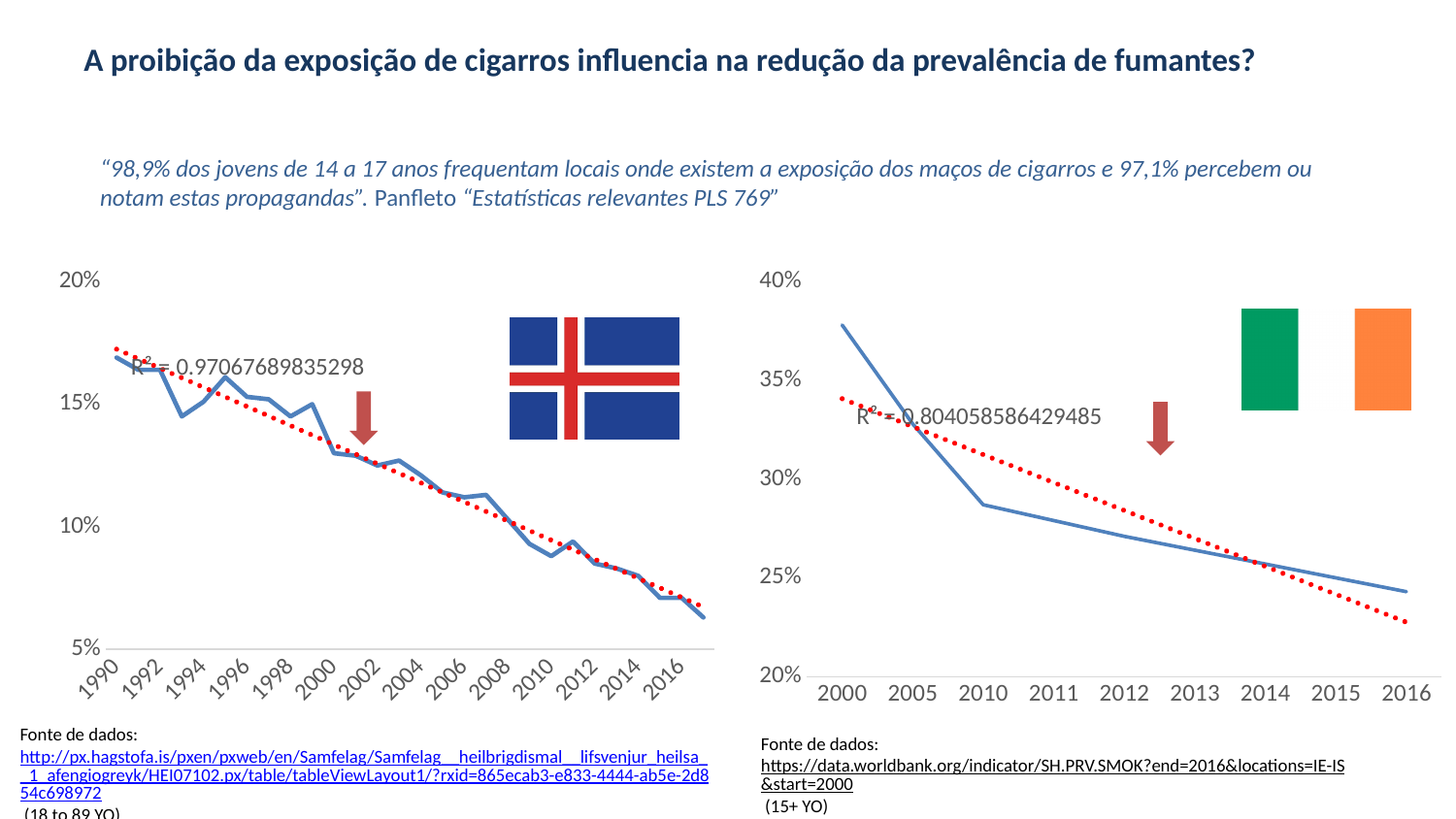
In the right chart (Ireland), is the value for 2000 greater or less than 35%? greater In the left chart (Iceland), is the value for 2000 greater or less than 10%? greater In the left chart (Iceland), which year has the higher value, 1990 or 2016? 1990 What R² value is printed on the left chart (Iceland)? R² = 0.97067689835298 What kind of chart is the left chart (with the Icelandic flag)? line chart In the right chart (Ireland), do the values rise or fall from 2000 to 2016? fall In the left chart (Iceland), is the value for 2016 greater or less than 10%? less What kind of chart is the right chart (with the Irish flag)? line chart How many year labels are shown on the x axis of the right chart (Ireland)? 9 In the left chart (Iceland), do the values rise or fall from 1990 to 2016? fall